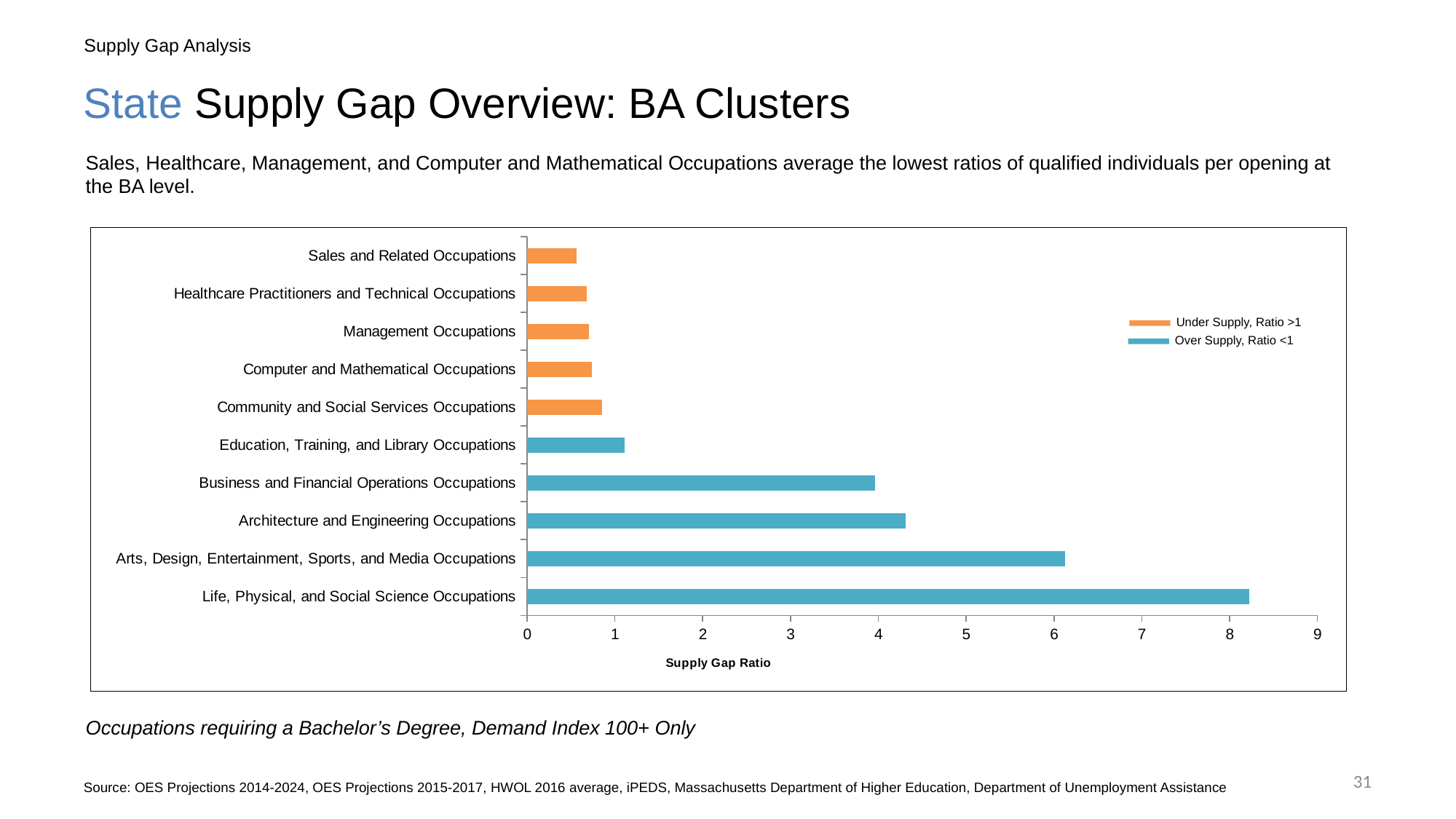
What is the title of the horizontal axis of the chart? Supply Gap Ratio Is the supply gap ratio for Architecture and Engineering Occupations greater or less than 4? greater Which has a larger supply gap ratio: Arts, Design, Entertainment, Sports, and Media Occupations or Architecture and Engineering Occupations? Arts, Design, Entertainment, Sports, and Media Occupations Which occupation category has the lowest supply gap ratio? Sales and Related Occupations Is the supply gap ratio for Life, Physical, and Social Science Occupations greater or less than 8? greater Is the supply gap ratio for Sales and Related Occupations greater or less than 1? less Which legend entry is shown in orange? Under Supply, Ratio >1 What kind of chart is shown on the slide? bar chart How many occupation categories are plotted in the chart? 10 How many series does the chart legend list? 2 Which occupation category has the highest supply gap ratio? Life, Physical, and Social Science Occupations